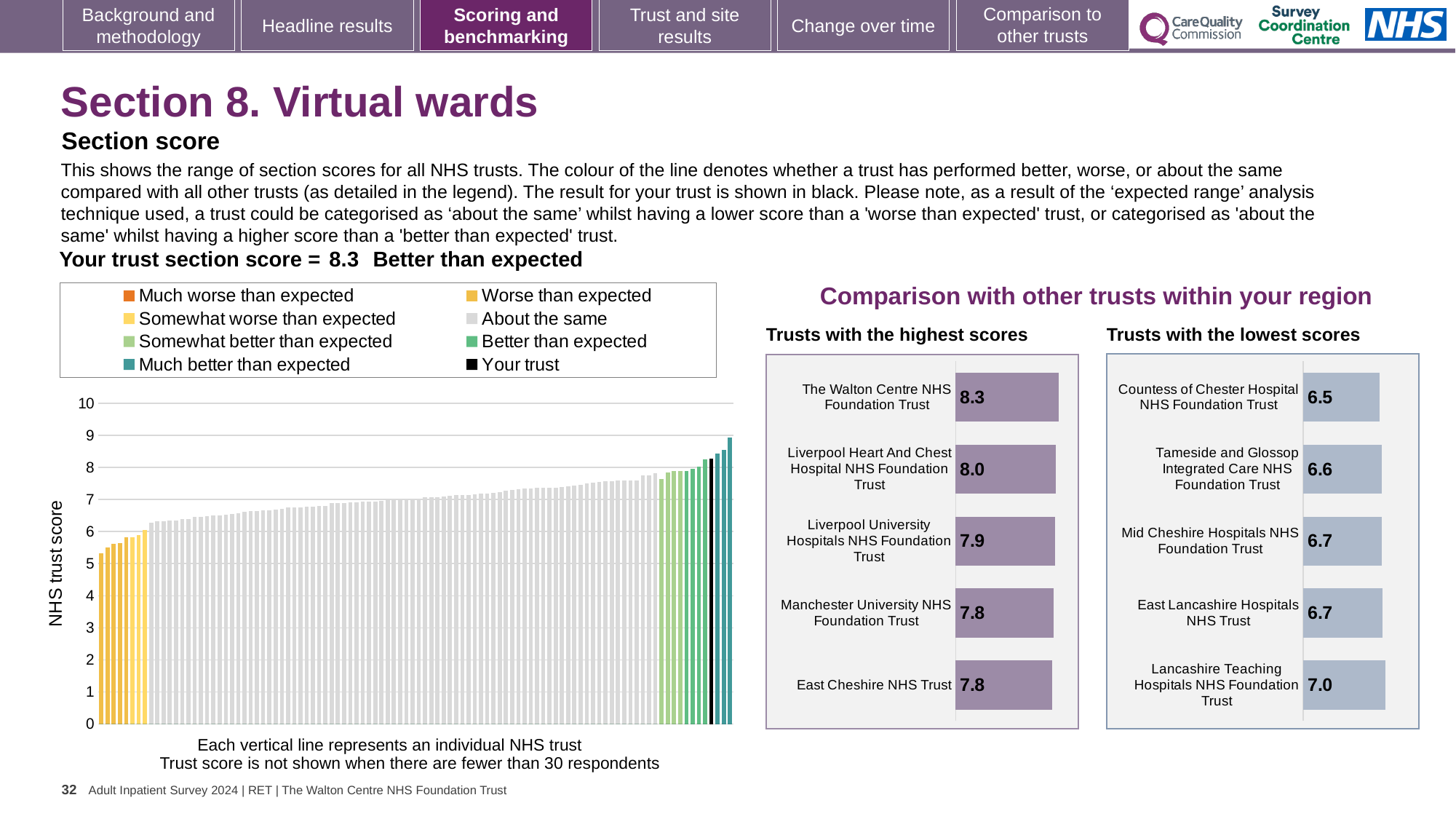
In the 'Trusts with the lowest scores' chart, what is the score for Countess of Chester Hospital NHS Foundation Trust? 6.5 In the 'Trusts with the lowest scores' chart, which has the larger score: Tameside and Glossop Integrated Care NHS Foundation Trust or Mid Cheshire Hospitals NHS Foundation Trust? Mid Cheshire Hospitals NHS Foundation Trust In the 'Trusts with the lowest scores' chart, which trust has the highest score shown? Lancashire Teaching Hospitals NHS Foundation Trust In the large chart on the left, do the bar values rise or fall from left to right? Rise In the 'Trusts with the highest scores' chart, what is the score for The Walton Centre NHS Foundation Trust? 8.3 How many trusts are listed in the 'Trusts with the lowest scores' chart? 5 In the 'Trusts with the highest scores' chart, what is the difference between the scores of The Walton Centre NHS Foundation Trust and East Cheshire NHS Trust? 0.5 How many entries does the legend above the large chart on the left list? 8 In the 'Trusts with the highest scores' chart, what is the score for Liverpool Heart And Chest Hospital NHS Foundation Trust? 8.0 What kind of chart is the large chart on the left showing NHS trust scores? Bar chart In the 'Trusts with the highest scores' chart, which trust has the lowest score shown? Manchester University NHS Foundation Trust and East Cheshire NHS Trust (both 7.8) In the 'Trusts with the lowest scores' chart, what is the score for Lancashire Teaching Hospitals NHS Foundation Trust? 7.0